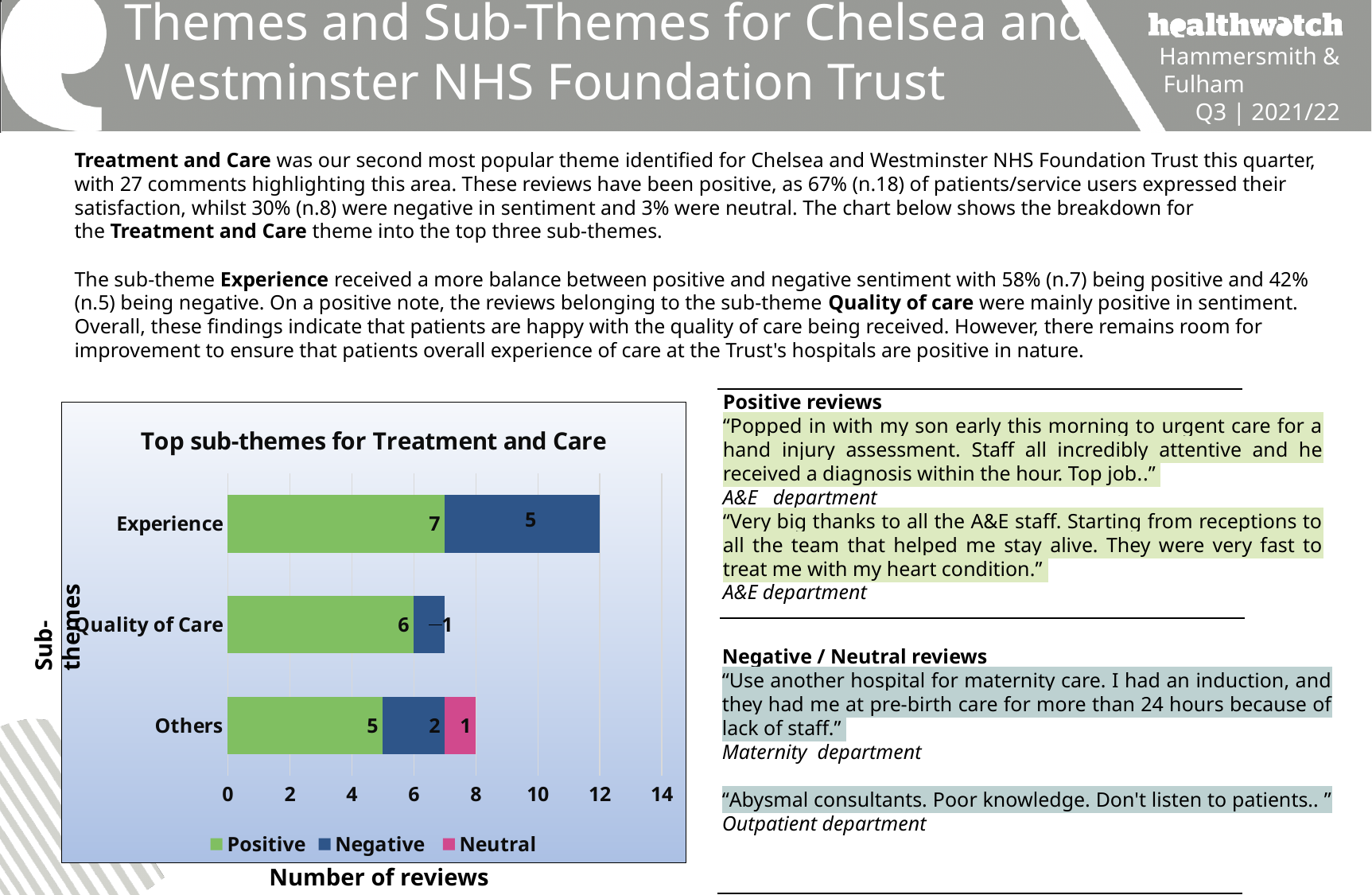
What is the Negative value for Quality of Care? 1 What is the Negative value for Experience? 5 What is the title of the chart? Top sub-themes for Treatment and Care Which sub-theme has the lowest Negative value? Quality of Care What type of chart is shown on the slide? Stacked bar chart What is the difference between the Positive values for Experience and Others? 2 What is the Positive value for Experience? 7 How many sub-theme categories are plotted in the chart? 3 What is the Neutral value for Others? 1 How many series does the legend of the chart list? 3 Which sub-theme has the highest Positive value? Experience What is the total number of reviews for the Experience bar? 12